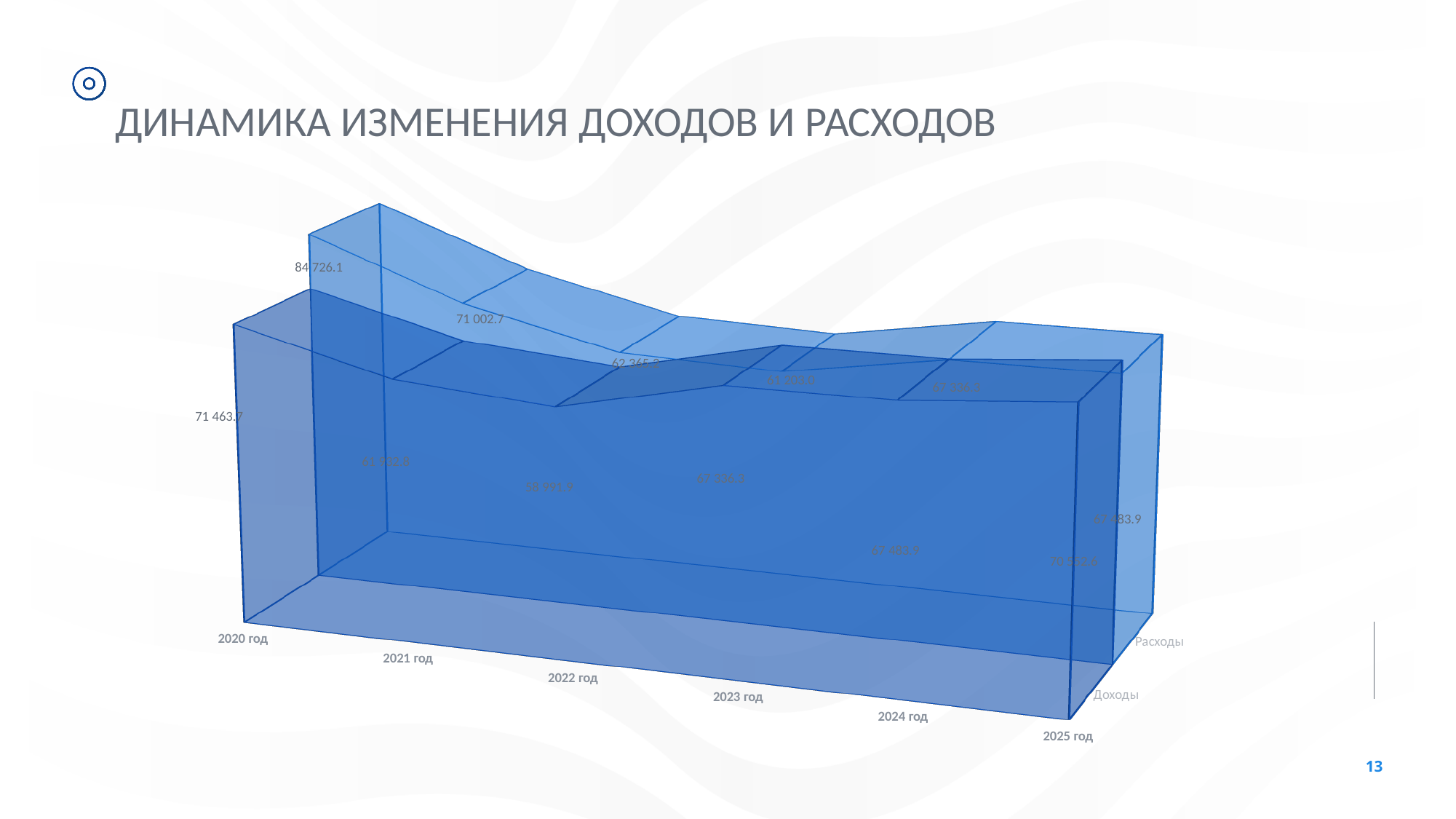
What is the title of the slide? ДИНАМИКА ИЗМЕНЕНИЯ ДОХОДОВ И РАСХОДОВ What is the value of Расходы for 2022 год? 62 365.2 By how much did Расходы decrease from 2020 год to 2021 год? 13 723.4 What is the value of Доходы for 2020 год? 71 463.7 In which year is the value of Расходы the highest? 2020 год How many years are shown along the x axis of the chart? 6 What is the value of Расходы for 2021 год? 71 002.7 How many series does the chart show? 2 What kind of chart is shown on the slide? Area chart For 2020 год, which is larger: Расходы or Доходы? Расходы Do the values of Расходы rise or fall from 2020 год to 2022 год? Fall What is the value of Расходы for 2020 год? 84 726.1